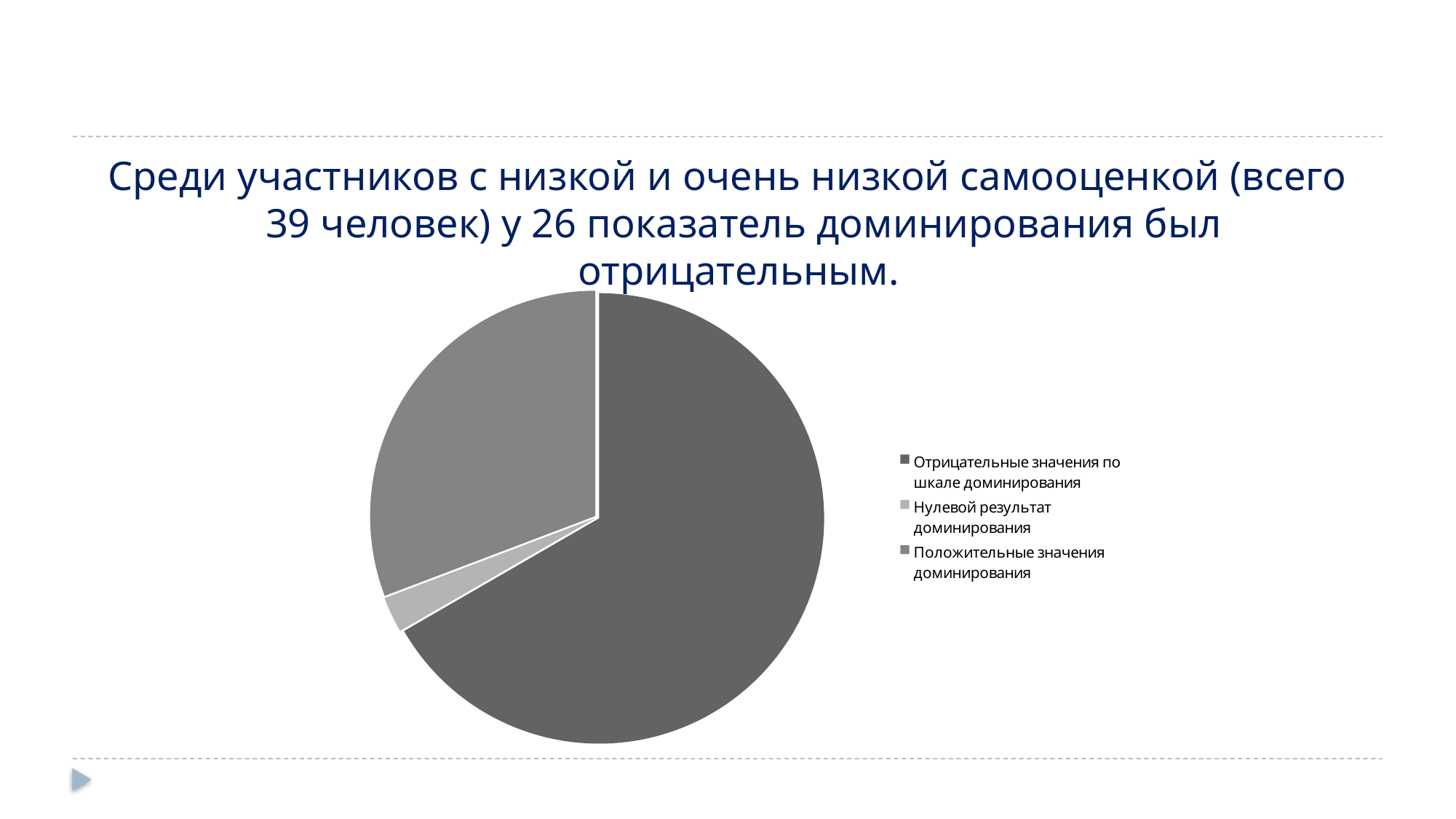
Which slice is larger: 'Положительные значения доминирования' or 'Нулевой результат доминирования'? Положительные значения доминирования What kind of chart is shown on the slide? pie chart Which legend entry is shown in the darkest grey colour? Отрицательные значения по шкале доминирования Which category has the smallest slice in the pie chart? Нулевой результат доминирования Which slice is larger: 'Отрицательные значения по шкале доминирования' or 'Положительные значения доминирования'? Отрицательные значения по шкале доминирования Which legend entry is shown in the lightest grey colour? Нулевой результат доминирования How many slices does the pie chart have? 3 Which category has the largest slice in the pie chart? Отрицательные значения по шкале доминирования How many entries does the legend of the pie chart list? 3